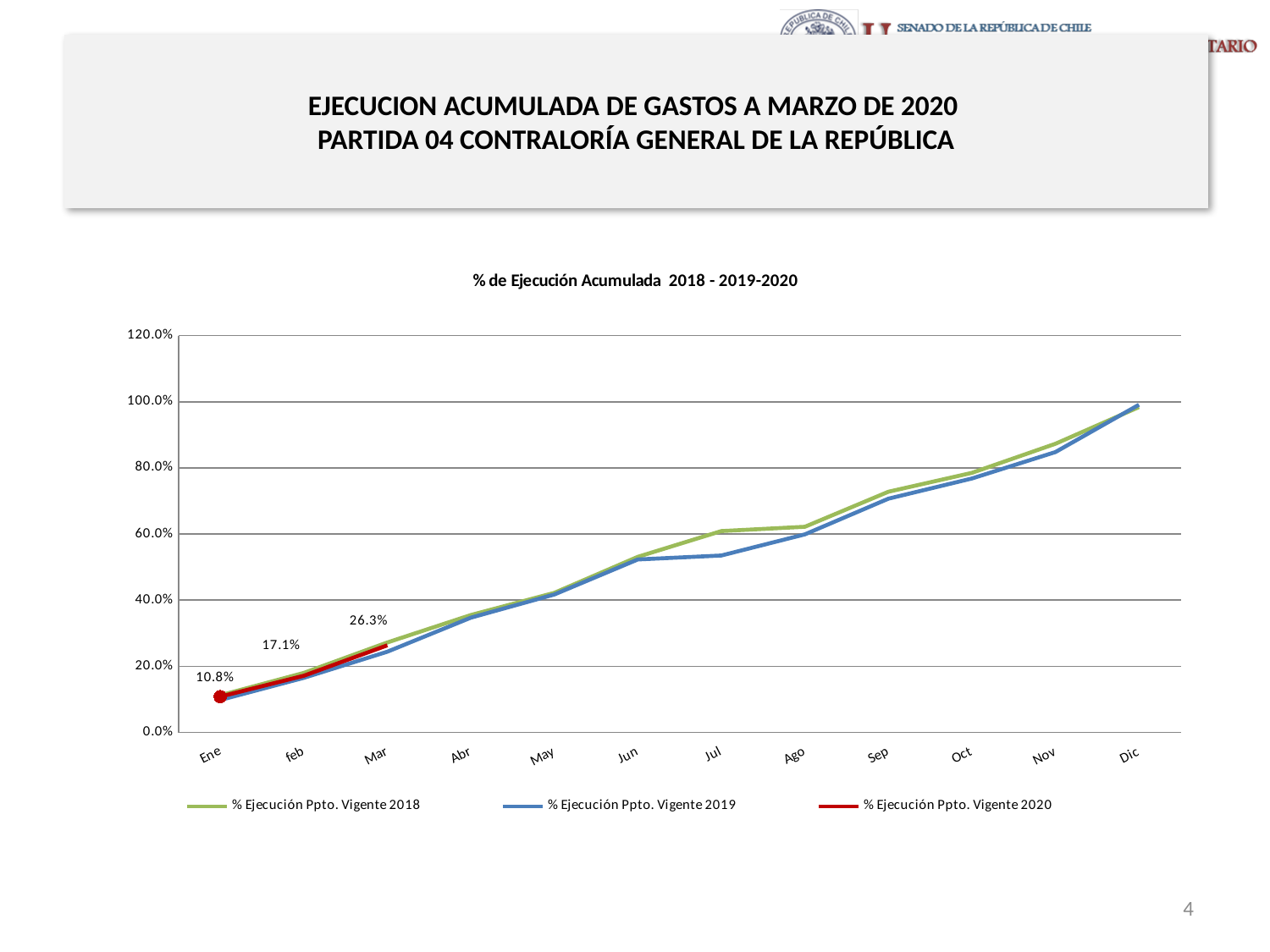
What is the value of % Ejecución Ppto. Vigente 2020 for Ene? 10.8% By how many percentage points did % Ejecución Ppto. Vigente 2020 increase from Ene to Mar? 15.5 In Jul, which series has the higher value: % Ejecución Ppto. Vigente 2018 or % Ejecución Ppto. Vigente 2019? % Ejecución Ppto. Vigente 2018 What is the value of % Ejecución Ppto. Vigente 2020 for Feb? 17.1% What kind of chart is shown on the slide? Line chart Do the values of % Ejecución Ppto. Vigente 2018 rise or fall from Ene to Dic? Rise What is the value of % Ejecución Ppto. Vigente 2020 for Mar? 26.3% How many series does the legend list? 3 Is the value of % Ejecución Ppto. Vigente 2019 for Abr greater or less than 40.0%? less Is the value of % Ejecución Ppto. Vigente 2018 for Sep greater or less than 60.0%? greater Is the value of % Ejecución Ppto. Vigente 2019 for Jul greater or less than 60.0%? less How many months are shown on the x axis of the chart? 12